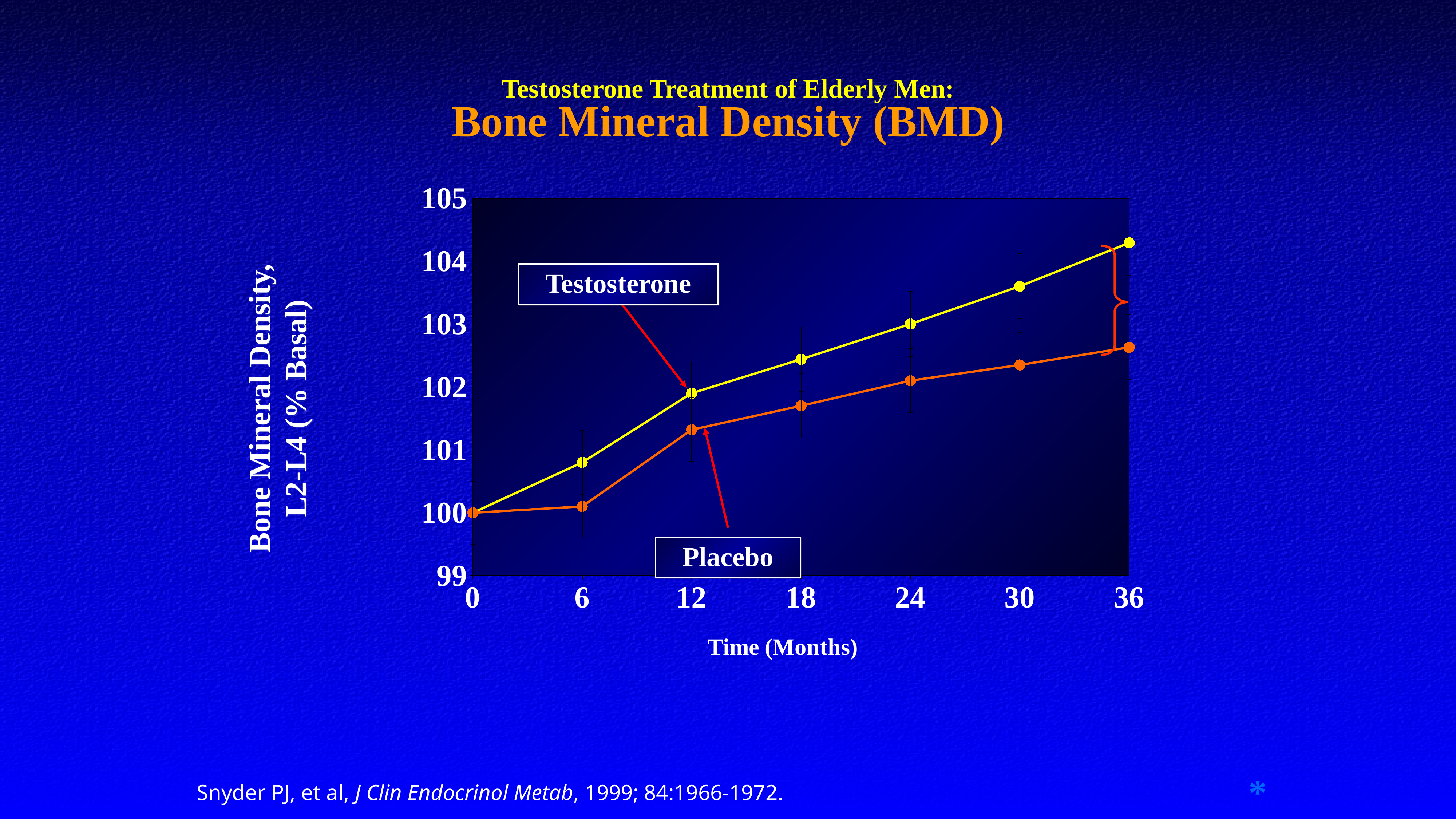
At 36 months, which group has the higher bone mineral density, Testosterone or Placebo? Testosterone Does the bone mineral density for the Testosterone group rise or fall over time? rise How many series are plotted on the chart? 2 Is the value for the Placebo group at 36 months greater or less than 103? less What is the bone mineral density value for the Testosterone group at 0 months? 100 Is the value for the Testosterone group at 36 months greater or less than 104? greater How many time points are plotted along the x axis? 7 Is the value for the Testosterone group at 6 months greater or less than 101? less What kind of chart is shown on the slide? line chart What is the bone mineral density value for the Placebo group at 0 months? 100 What is the label on the x axis of the chart? Time (Months)